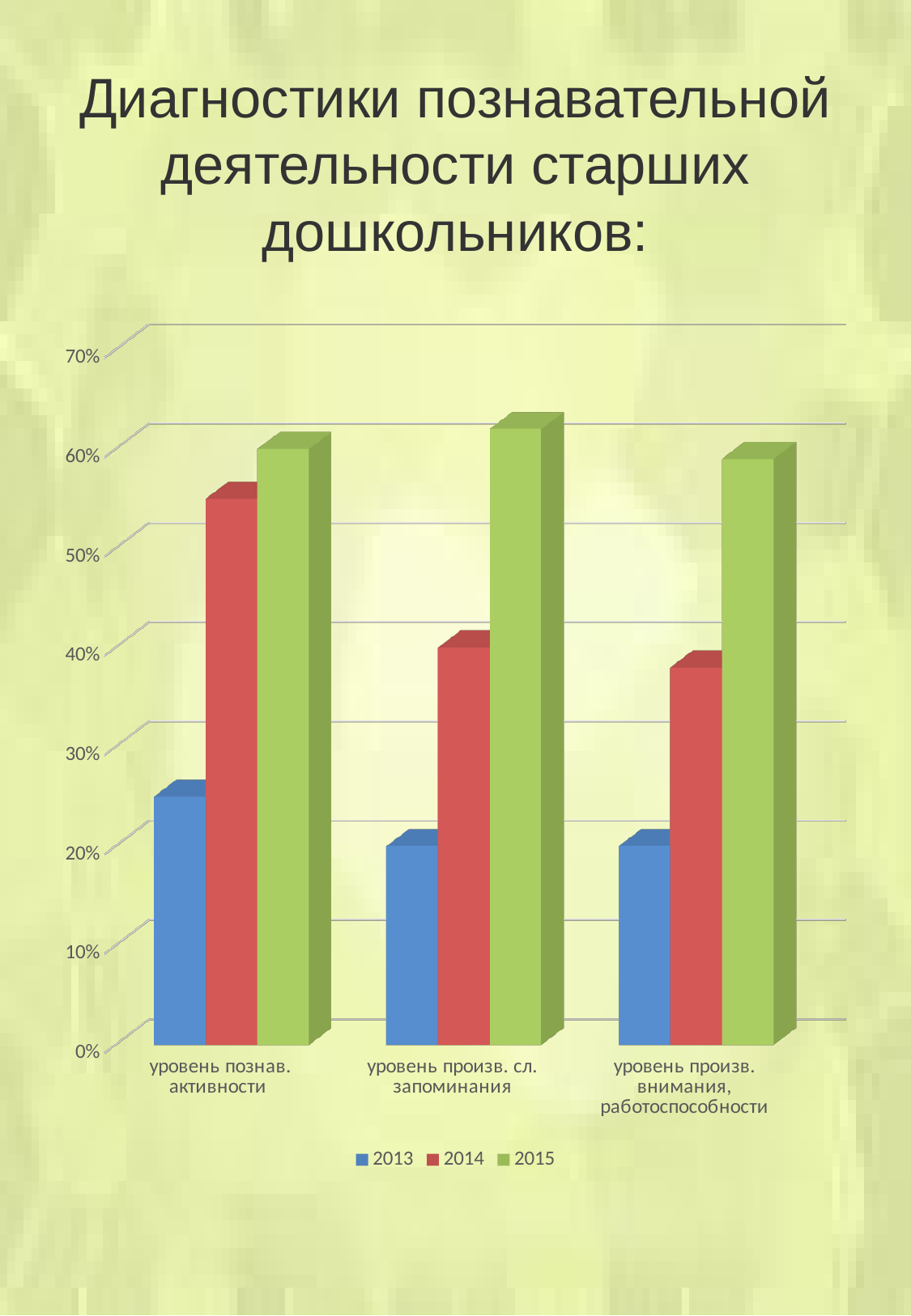
How many series does the legend list? 3 Which is larger for 'уровень произв. внимания, работоспособности': the 2014 value or the 2015 value? 2015 What kind of chart is shown on the slide? bar chart Which series are listed in the legend? 2013, 2014, 2015 Which series has the highest value for 'уровень познав. активности'? 2015 Is the 2013 value for 'уровень познав. активности' greater or less than 30%? less Is the 2014 value for 'уровень познав. активности' greater or less than 50%? greater Is the 2015 value for 'уровень произв. сл. запоминания' greater or less than 50%? greater Which series has the lowest value for 'уровень произв. сл. запоминания'? 2013 How many categories are shown on the x axis? 3 For the 2014 series, which category has the highest value? уровень познав. активности Within each category, do the values rise or fall from 2013 to 2015? rise